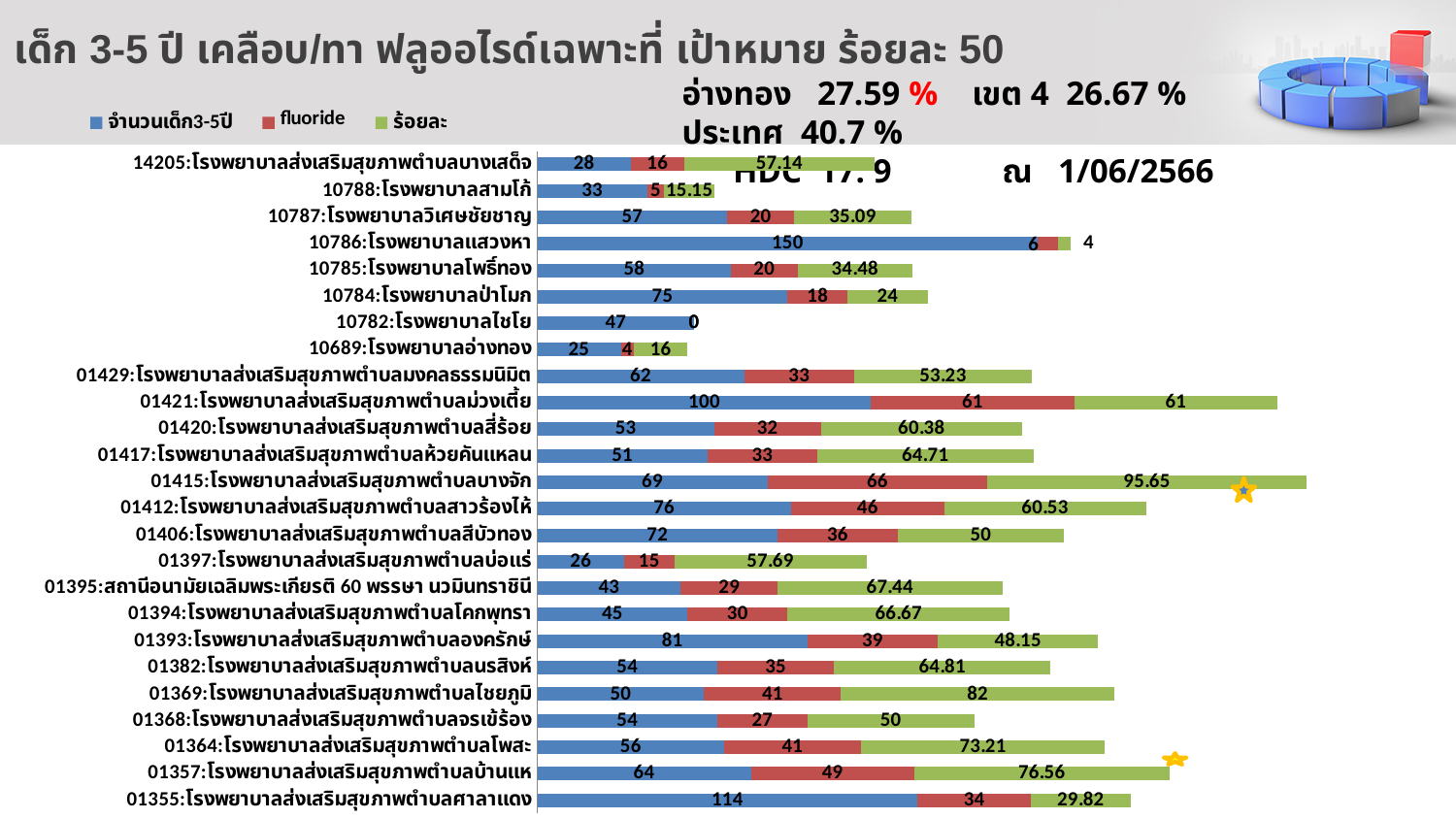
What kind of chart is shown on the slide? stacked bar chart Which has a larger ร้อยละ value, 01369:โรงพยาบาลส่งเสริมสุขภาพตำบลไชยภูมิ or 01364:โรงพยาบาลส่งเสริมสุขภาพตำบลโพสะ? 01369:โรงพยาบาลส่งเสริมสุขภาพตำบลไชยภูมิ What is the ร้อยละ value for 01415:โรงพยาบาลส่งเสริมสุขภาพตำบลบางจัก? 95.65 Which hospital has the highest ร้อยละ value? 01415:โรงพยาบาลส่งเสริมสุขภาพตำบลบางจัก What is the target percentage (เป้าหมาย ร้อยละ) stated in the chart title? 50 What is the จำนวนเด็ก3-5ปี value for 10786:โรงพยาบาลแสวงหา? 150 How many series does the legend list? 3 Which hospital has the highest fluoride value? 01415:โรงพยาบาลส่งเสริมสุขภาพตำบลบางจัก Which hospital has the highest จำนวนเด็ก3-5ปี value? 10786:โรงพยาบาลแสวงหา What is the difference between the จำนวนเด็ก3-5ปี values of 01355:โรงพยาบาลส่งเสริมสุขภาพตำบลศาลาแดง and 01421:โรงพยาบาลส่งเสริมสุขภาพตำบลม่วงเตี้ย? 14 How many hospitals (categories) are plotted on the chart? 25 What is the fluoride value for 01357:โรงพยาบาลส่งเสริมสุขภาพตำบลบ้านแห? 49